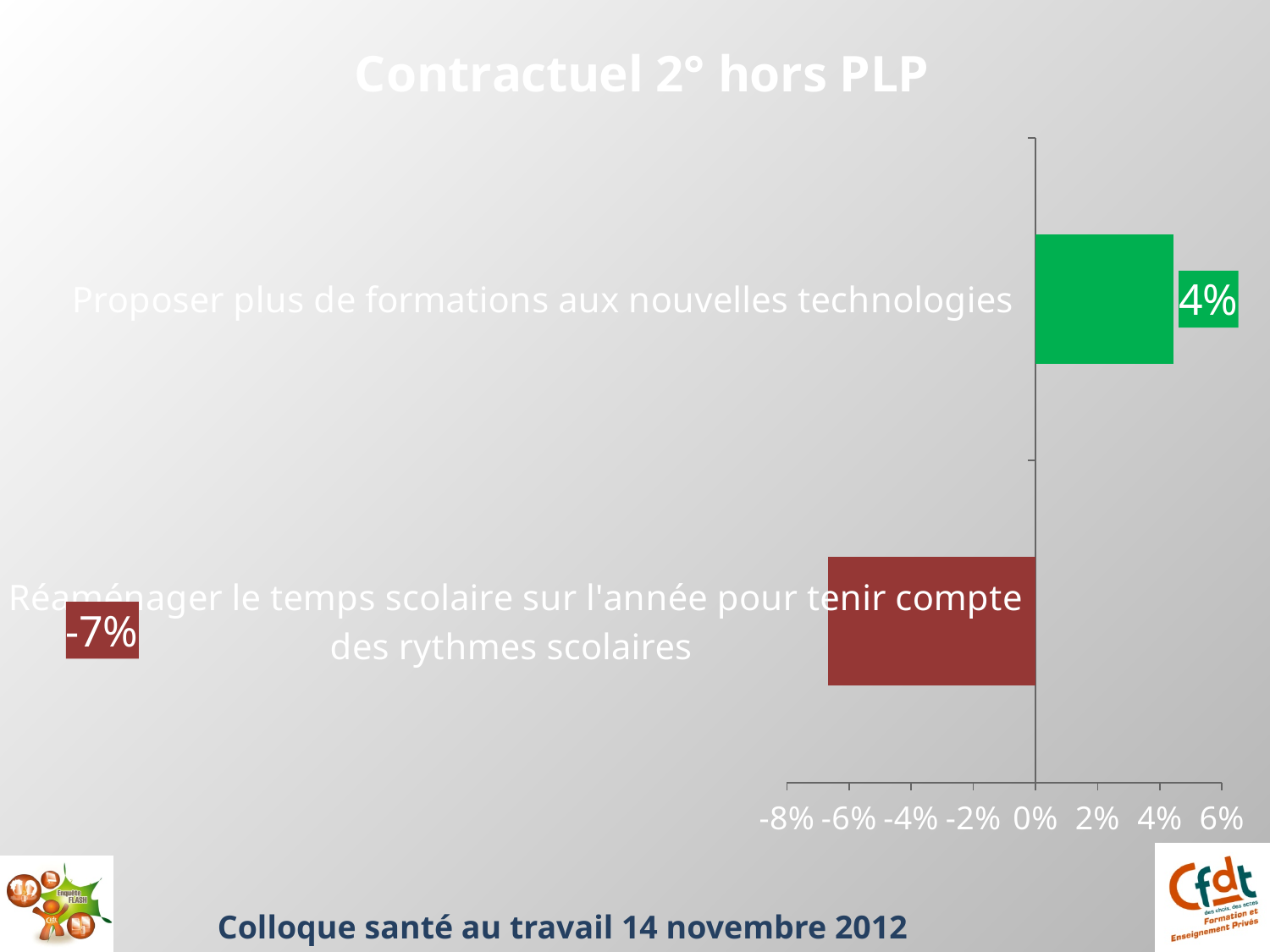
What colour is the bar for "Réaménager le temps scolaire sur l'année pour tenir compte des rythmes scolaires"? Red What kind of chart is shown on the slide? Bar chart Which is larger: the value for "Proposer plus de formations aux nouvelles technologies" or the value for "Réaménager le temps scolaire sur l'année pour tenir compte des rythmes scolaires"? Proposer plus de formations aux nouvelles technologies Is the value for "Proposer plus de formations aux nouvelles technologies" greater or less than 2%? greater What is the value for "Proposer plus de formations aux nouvelles technologies"? 4% What is the title of the chart? Contractuel 2° hors PLP What is the value for "Réaménager le temps scolaire sur l'année pour tenir compte des rythmes scolaires"? -7% What is the difference between the value for "Proposer plus de formations aux nouvelles technologies" and the value for "Réaménager le temps scolaire sur l'année pour tenir compte des rythmes scolaires"? 11 percentage points Which category has the lowest value? Réaménager le temps scolaire sur l'année pour tenir compte des rythmes scolaires Is the value for "Réaménager le temps scolaire sur l'année pour tenir compte des rythmes scolaires" greater or less than -4%? less Which category has the highest value? Proposer plus de formations aux nouvelles technologies How many categories are shown in the chart? 2